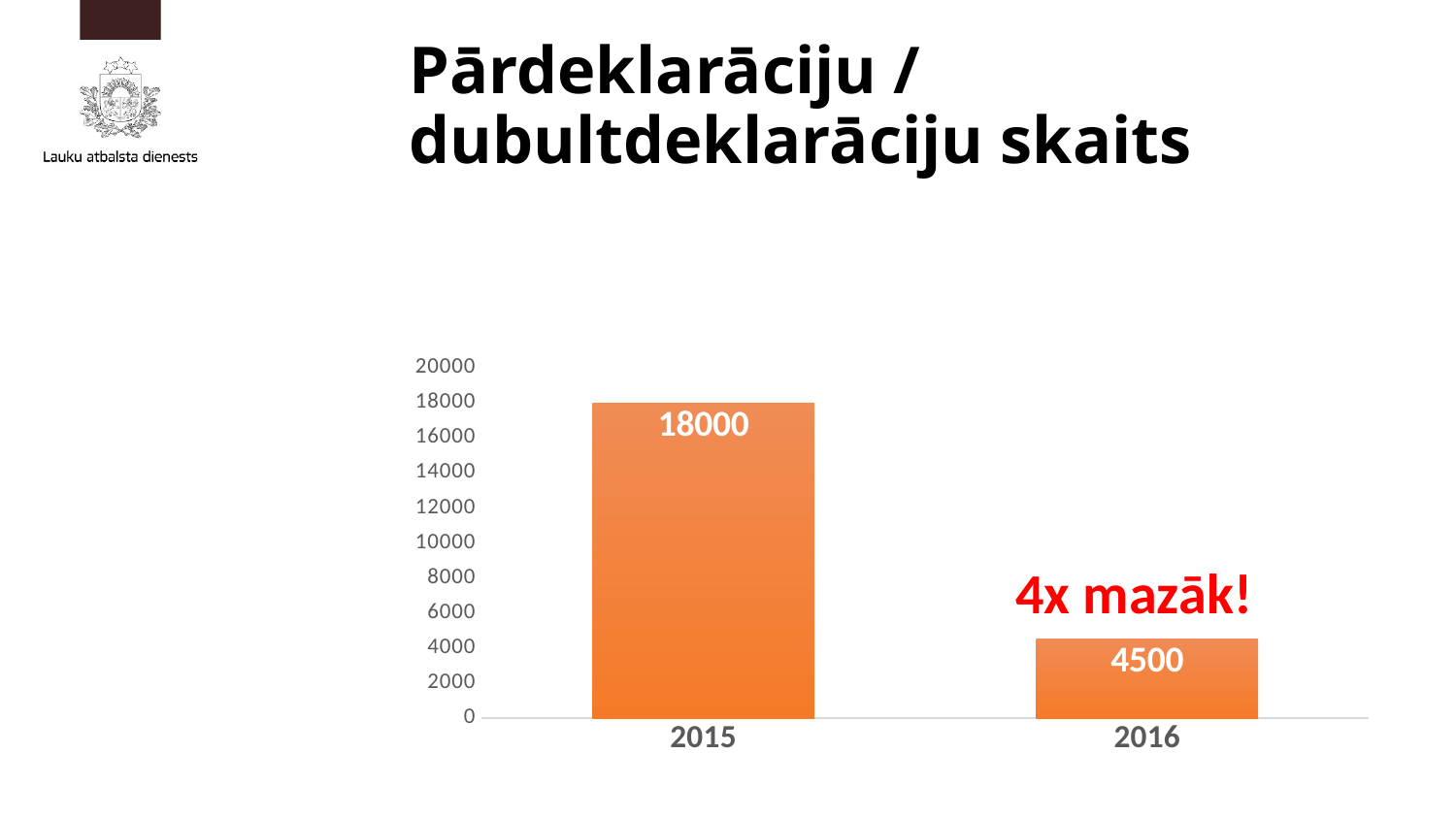
Which is larger, the value for 2015 or the value for 2016? 2015 How many categories are shown on the x axis? 2 What is the difference between the values for 2015 and 2016? 13500 What red annotation text is shown next to the 2016 bar? 4x mazāk! What is the value for 2016? 4500 Do the values rise or fall from 2015 to 2016? fall What kind of chart is shown on the slide? bar chart Which year has the highest value? 2015 Which year has the lowest value? 2016 Is the value for 2015 greater or less than 16000? greater What is the value for 2015? 18000 Is the value for 2016 greater or less than 6000? less